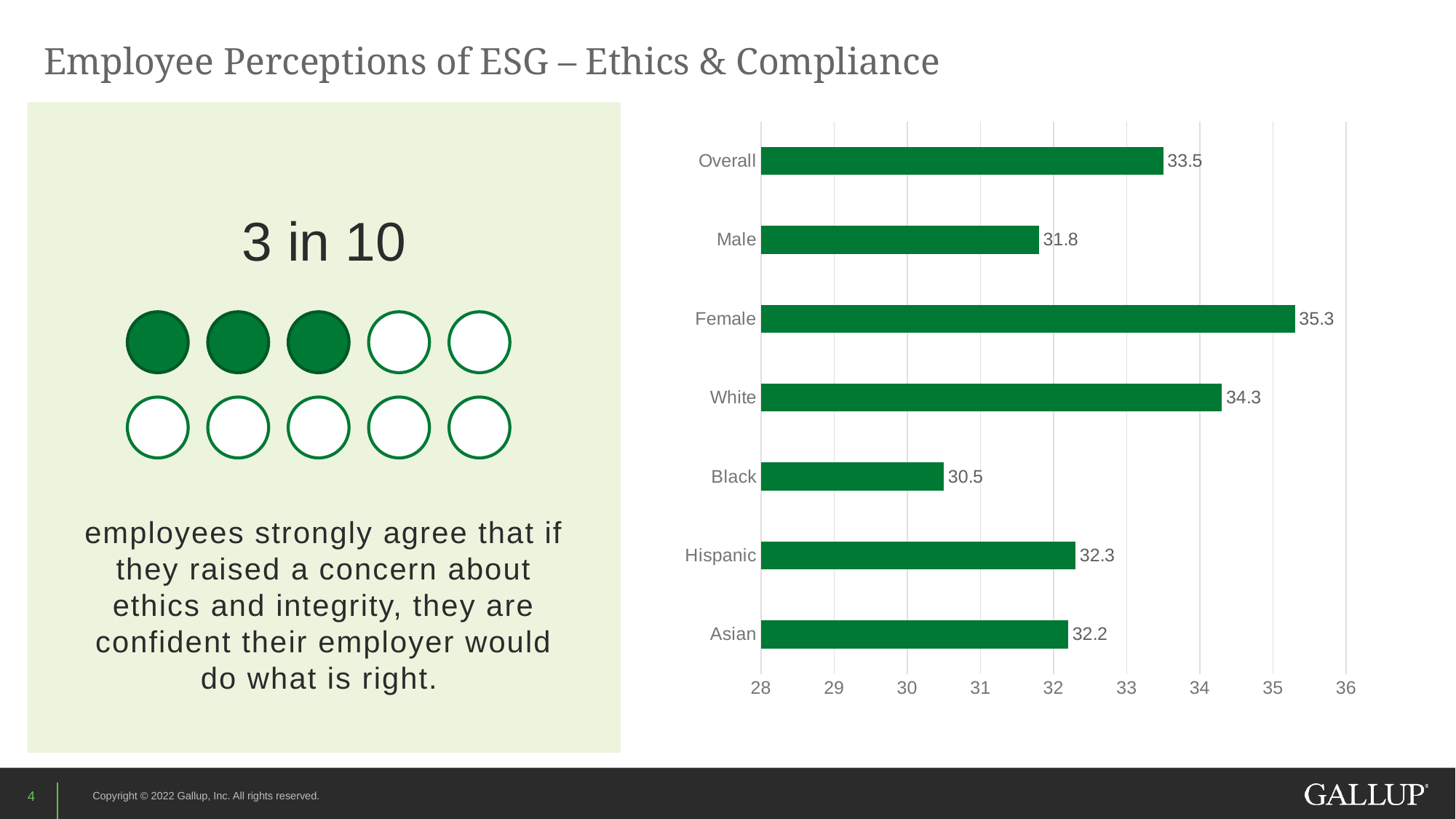
What kind of chart is shown on the slide? bar chart What is the maximum value shown on the x axis of the bar chart? 36 Which category has the lowest value in the bar chart? Black What is the difference between the values for Female and Male? 3.5 Is the value for White greater or less than 34? greater How many categories are shown in the bar chart? 7 Which is larger, the value for Male or the value for Hispanic? Hispanic What is the value for Overall in the bar chart? 33.5 What is the value for Female in the bar chart? 35.3 What is the difference between the values for White and Black? 3.8 What is the value for Black in the bar chart? 30.5 Which category has the highest value in the bar chart? Female